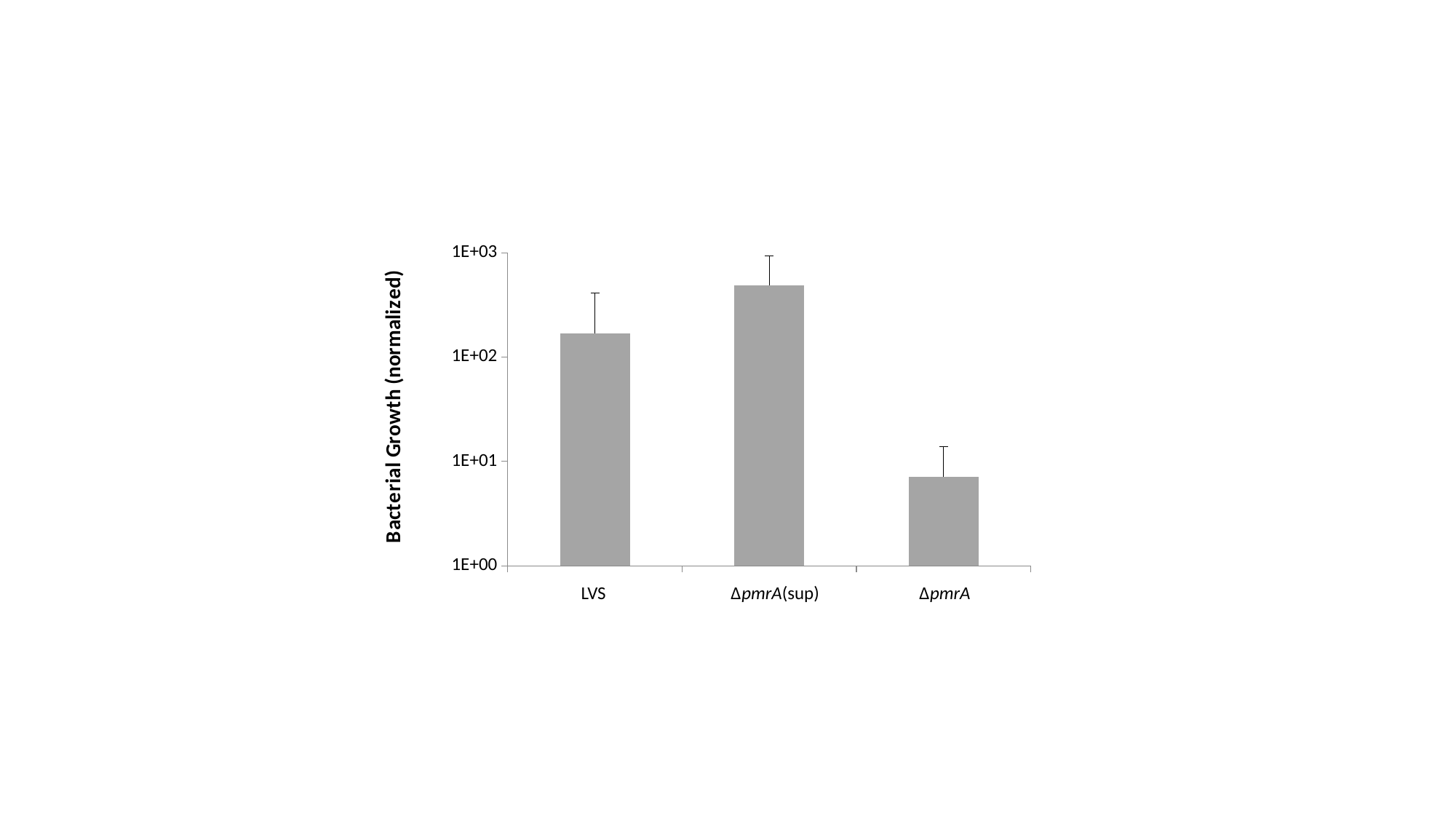
Is the value for LVS greater or less than 1E+02? greater Is the value for ΔpmrA greater or less than 1E+01? less Is the value for ΔpmrA(sup) greater or less than 1E+03? less What is the label of the first category on the x axis? LVS What is the label of the y axis? Bacterial Growth (normalized) What kind of chart is shown on the slide? bar chart Which has the larger bacterial growth value, LVS or ΔpmrA(sup)? ΔpmrA(sup) How many categories are plotted on the x axis? 3 Which has the larger bacterial growth value, LVS or ΔpmrA? LVS Which category has the highest bacterial growth? ΔpmrA(sup) Which category has the lowest bacterial growth? ΔpmrA